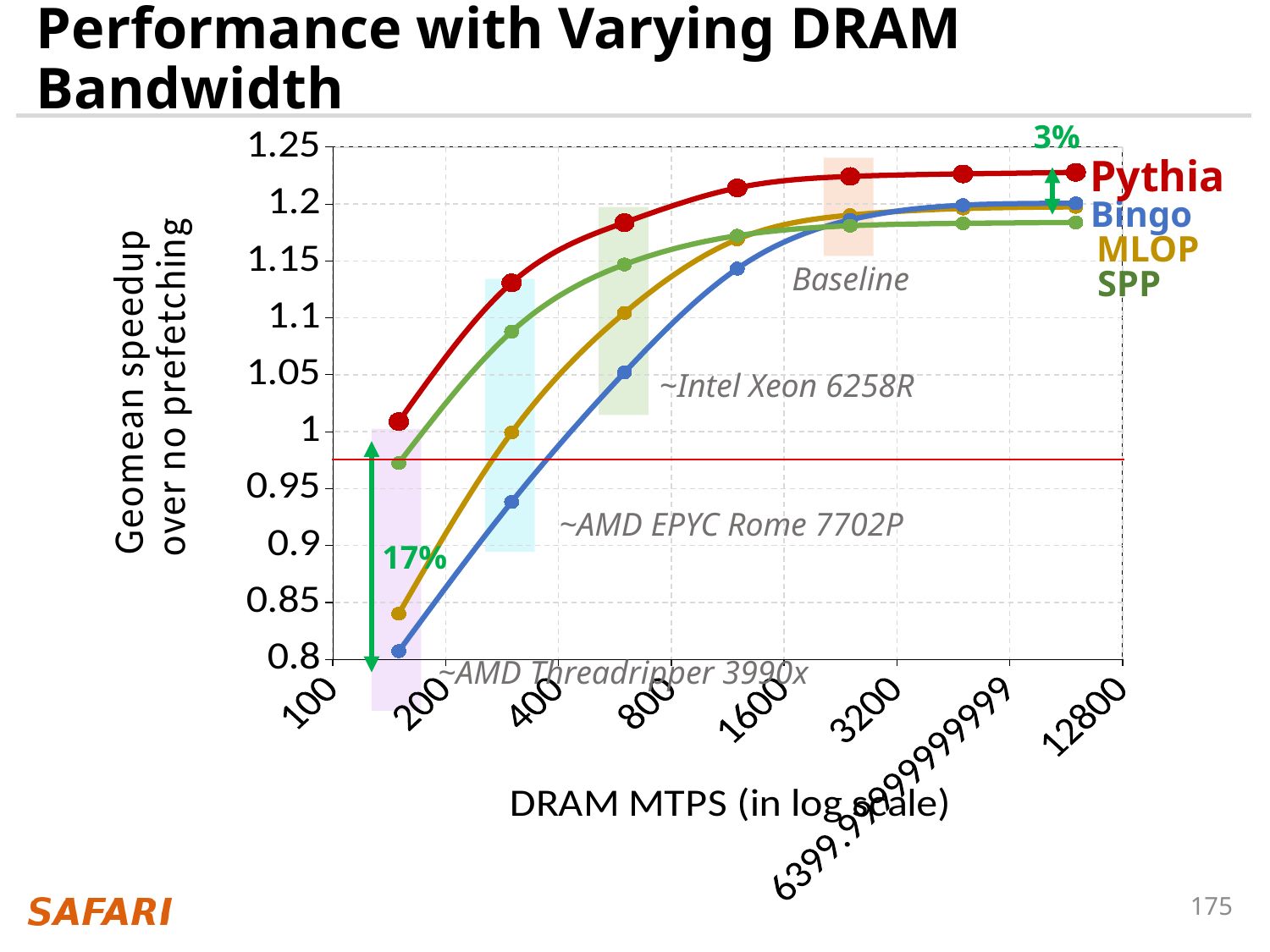
Is the value for Pythia at the rightmost data point greater or less than 1.2? greater What percentage is annotated next to the green arrow at the right end of the chart? 3% Do the values for Pythia rise or fall as DRAM MTPS increases along the x axis? rise Is the value for Bingo at the leftmost data point greater or less than 0.85? less What kind of chart is shown on the slide? line chart At the leftmost data point, which is larger: the value for Pythia or the value for SPP? Pythia What is the title of the x axis of the chart? DRAM MTPS (in log scale) How many series are plotted in the chart? 4 Is the value for MLOP at the leftmost data point greater or less than 0.9? less Which series has the highest value at the rightmost data point? Pythia Which series has the lowest value at the leftmost data point? Bingo How many data points are plotted for each series? 7